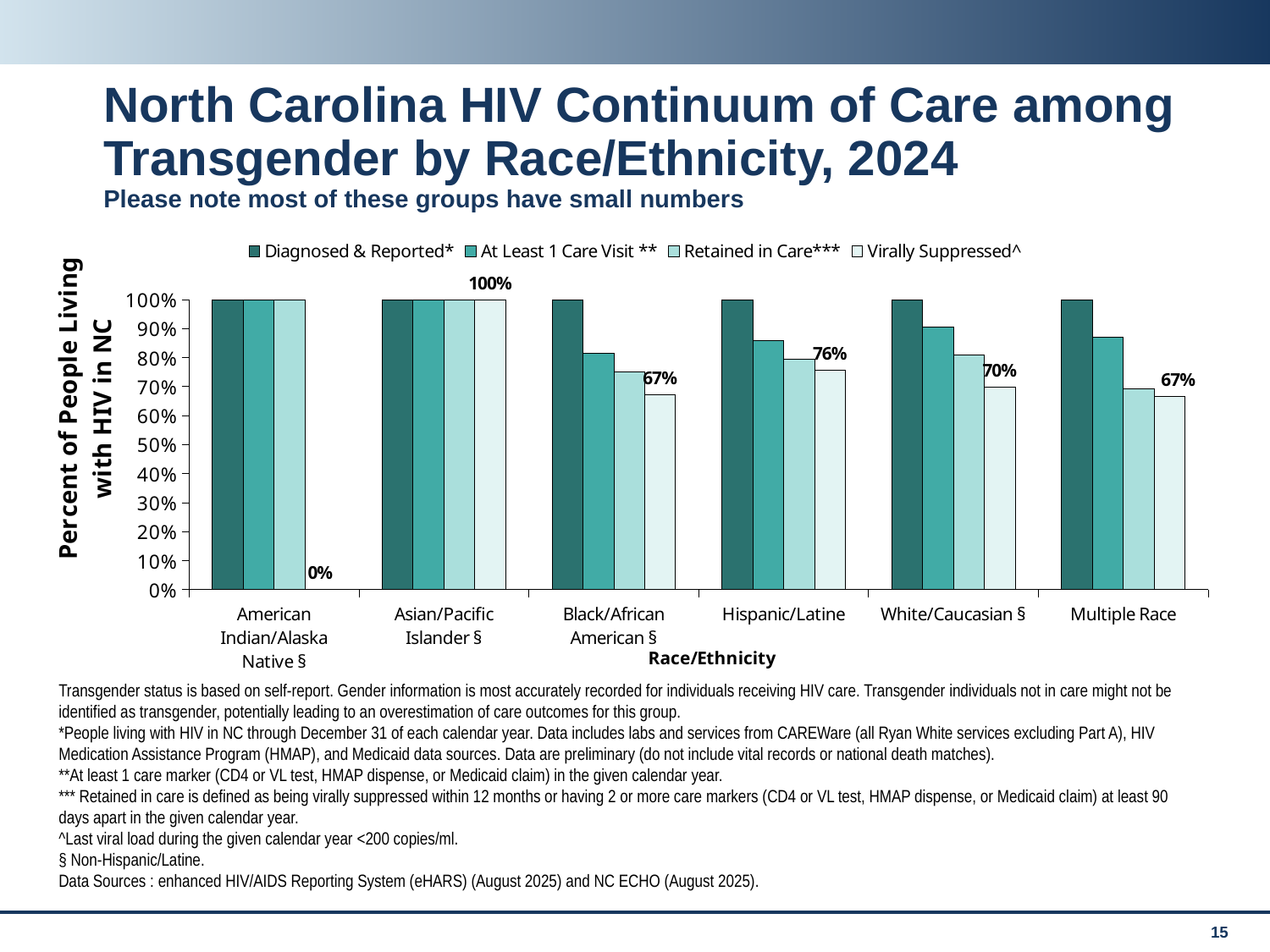
How many series does the legend list? 4 Is the At Least 1 Care Visit ** value for Black/African American § greater or less than 90%? less What is the difference between the Virally Suppressed^ values for Hispanic/Latine and Multiple Race? 9% Which is larger: the Virally Suppressed^ value for White/Caucasian § or for Black/African American §? White/Caucasian § What kind of chart is shown on the slide? Bar chart Which race/ethnicity group has the highest Virally Suppressed^ value? Asian/Pacific Islander § Is the Retained in Care*** value for Hispanic/Latine greater or less than 70%? greater What is the Virally Suppressed^ value for Hispanic/Latine? 76% What is the Virally Suppressed^ value for American Indian/Alaska Native §? 0% Which race/ethnicity group has the lowest Virally Suppressed^ value? American Indian/Alaska Native § What is the Virally Suppressed^ value for White/Caucasian §? 70% How many race/ethnicity categories are shown on the x axis? 6